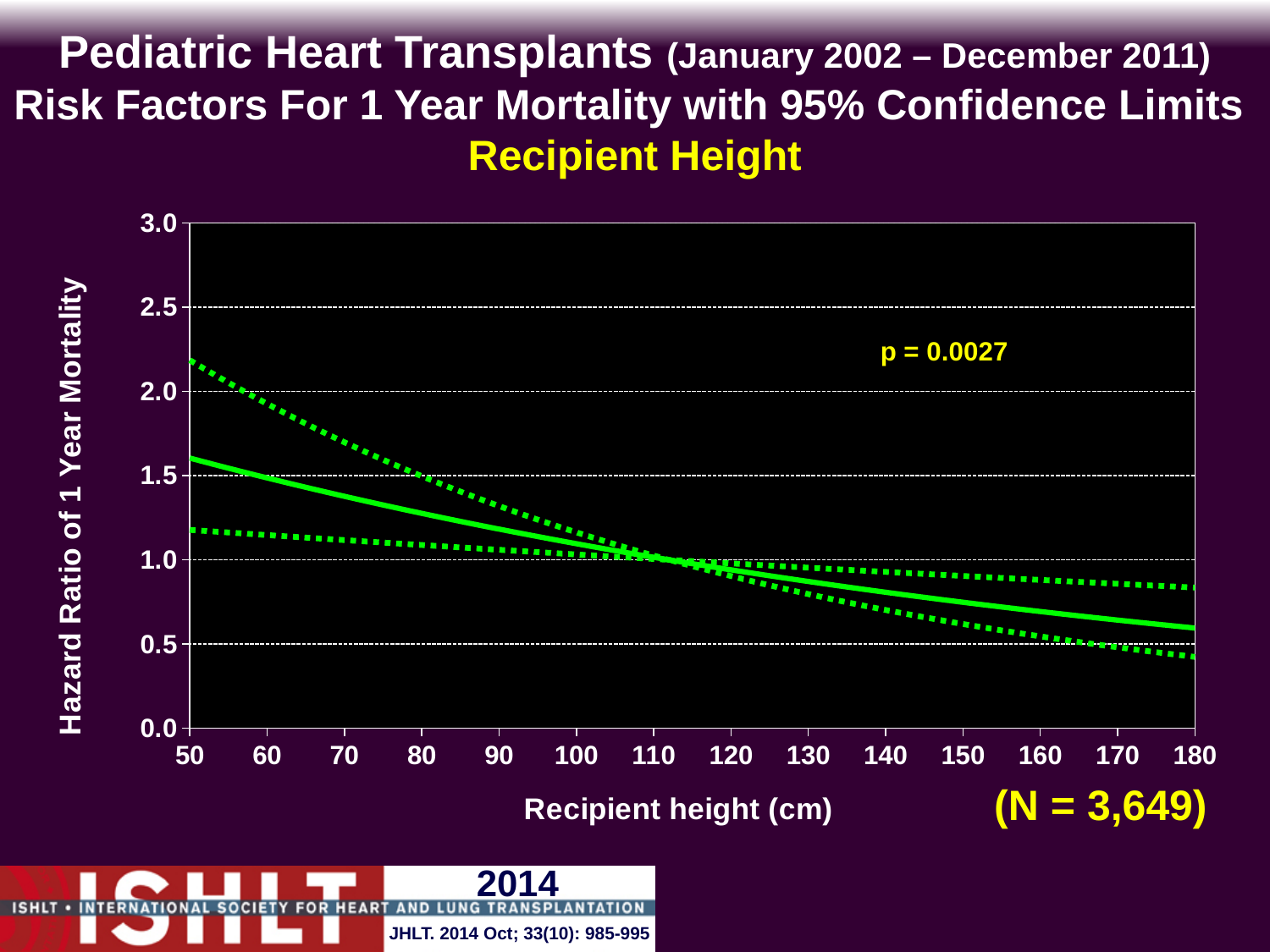
How many lines are plotted on the chart? 3 Is the hazard ratio (solid line) at a recipient height of 180 cm greater or less than 1.0? less Is the upper 95% confidence limit at a recipient height of 180 cm greater or less than 1.0? less What p-value is shown on the chart? p = 0.0027 Is the hazard ratio (solid line) higher at a recipient height of 60 cm or at 160 cm? 60 cm What kind of chart is shown on the slide? line chart Is the upper 95% confidence limit at a recipient height of 50 cm greater or less than 2.0? greater Does the hazard ratio of 1 year mortality rise or fall as recipient height increases from 50 cm to 180 cm? fall What is the sample size (N) shown on the slide? N = 3,649